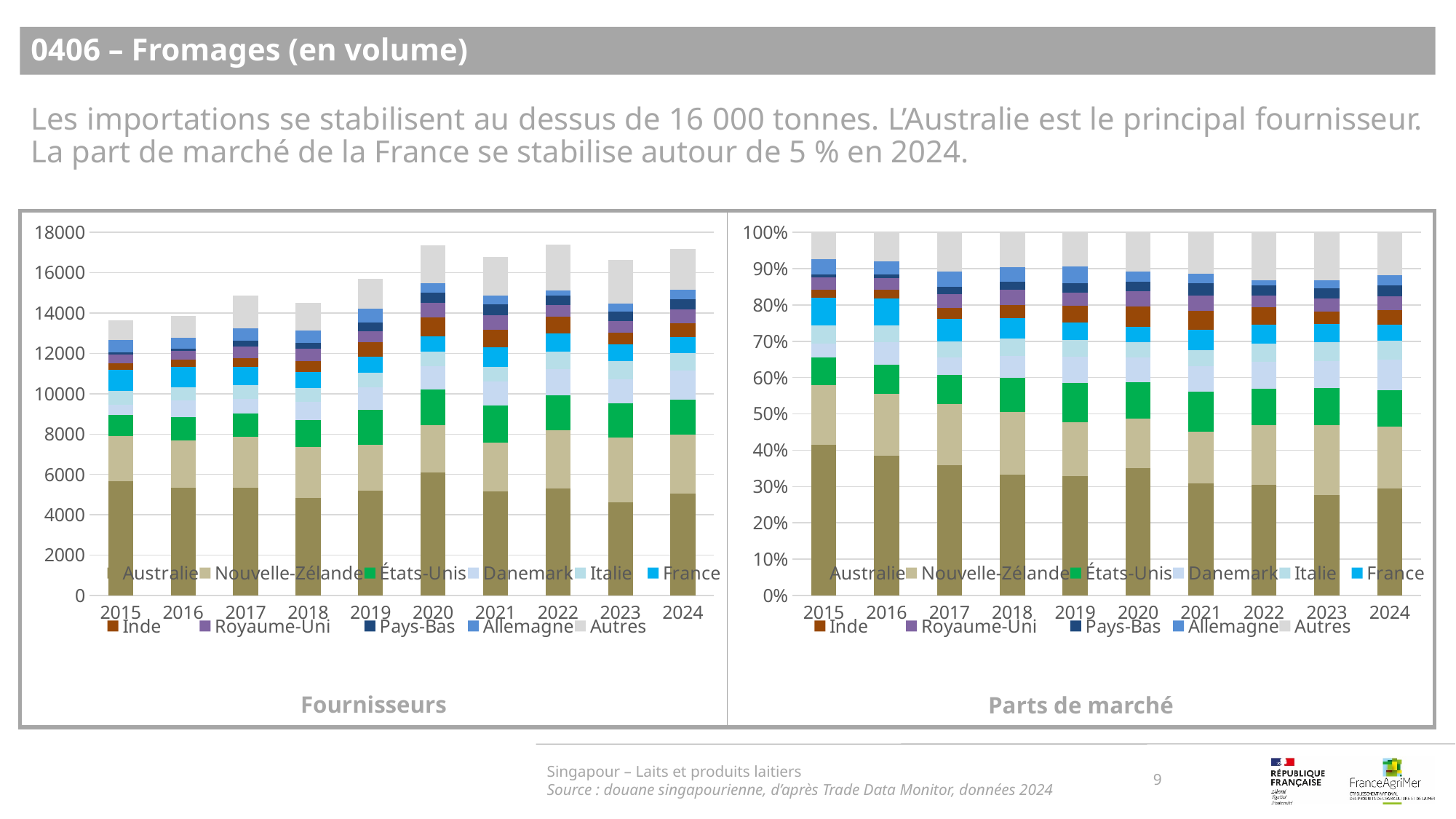
What is the title of the chart on the right of the slide? Parts de marché In the 'Parts de marché' chart, in which year is the share for Australie the highest? 2015 How many years are shown on the x axis of the 'Parts de marché' chart? 10 In the 'Fournisseurs' chart, is the value for Australie in 2015 greater or less than 4000? greater How many series does the legend of the 'Fournisseurs' chart list? 11 In the 'Fournisseurs' chart, is the total of the stacked bar for 2020 greater or less than 16000? greater In the 'Parts de marché' chart, is the share for Australie in 2015 greater or less than 40%? greater What kind of chart is the 'Fournisseurs' chart on the left? stacked bar chart In the 'Fournisseurs' chart, which year has the larger total bar, 2015 or 2020? 2020 In the 'Fournisseurs' chart, do the total bar heights generally rise or fall from 2015 to 2024? rise